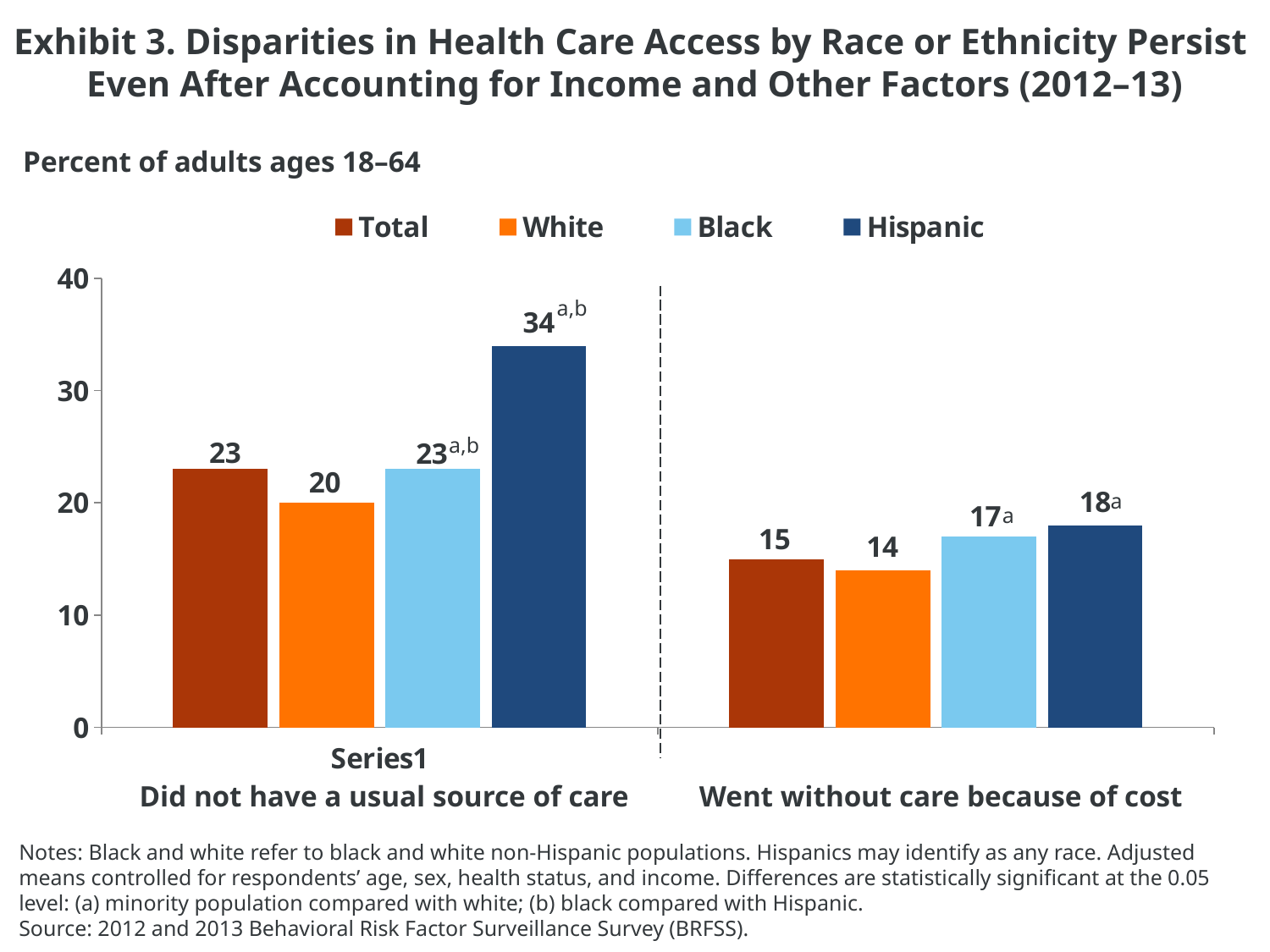
Which group has the highest value for going without care because of cost? Hispanic How many series does the legend list? 4 What is the difference between the Hispanic and White values for not having a usual source of care? 14 What is the difference between the Black and Total values for going without care because of cost? 2 What kind of chart is shown on the slide? Bar chart What colour are the bars for the Hispanic series? Dark blue What is the Total value for adults who did not have a usual source of care? 23 What is the value for White adults who went without care because of cost? 14 Which is larger: the Black value for going without care because of cost or the White value for the same measure? Black Which group has the lowest value for not having a usual source of care? White Is the Hispanic value for not having a usual source of care greater or less than 30? greater What is the value for Hispanic adults who did not have a usual source of care? 34